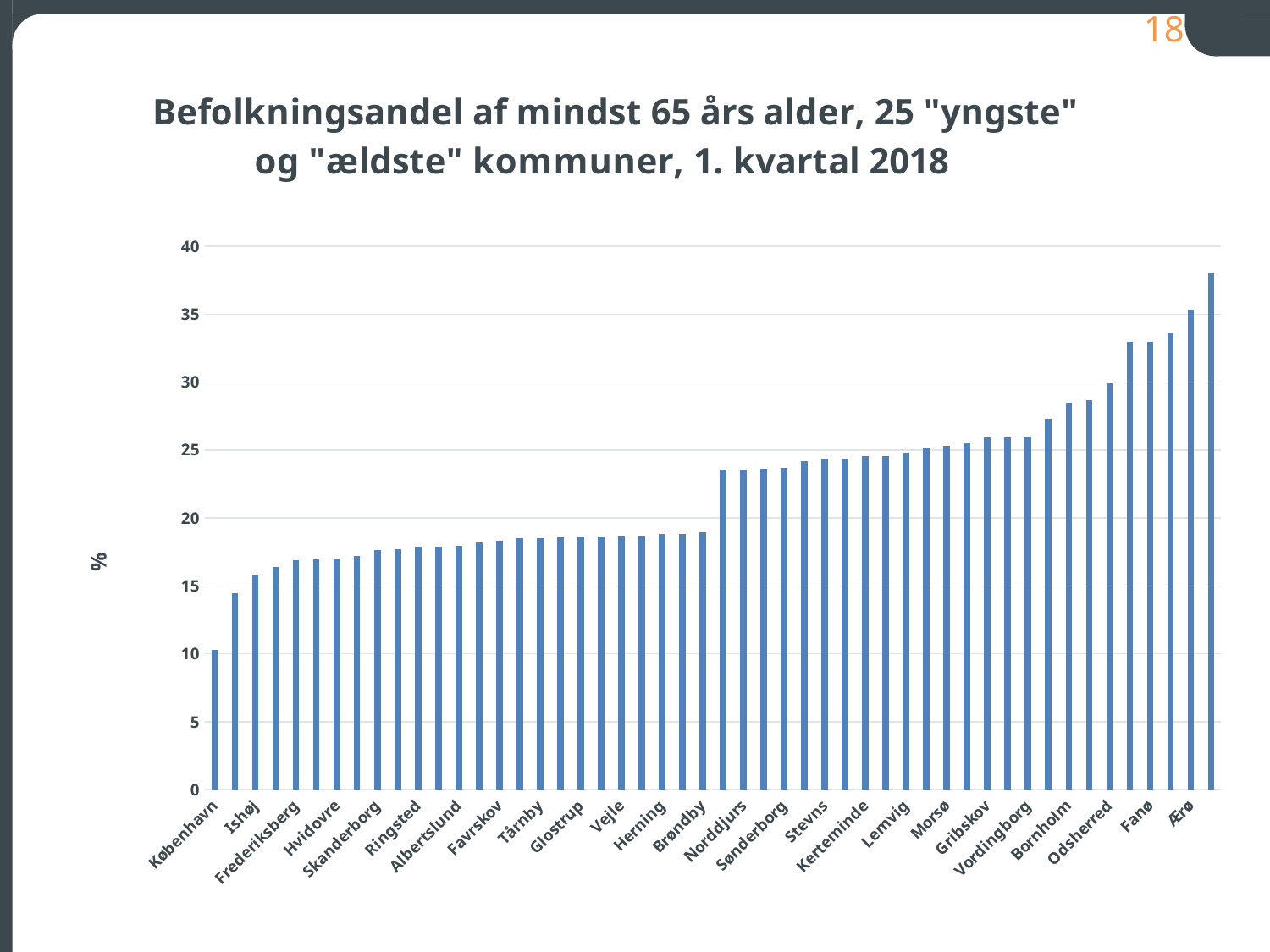
Is the value for Norddjurs greater or less than 20? greater What kind of chart is shown on the slide? bar chart Which has a larger value, Fanø or Bornholm? Fanø Is the value for Brøndby greater or less than 20? less Is the value for Bornholm greater or less than 25? greater What is the title of the chart? Befolkningsandel af mindst 65 års alder, 25 "yngste" og "ældste" kommuner, 1. kvartal 2018 Which municipality has the lowest value in the chart? København What is the label on the vertical axis of the chart? % Which has a larger value, Norddjurs or Brøndby? Norddjurs Do the values rise or fall from left to right along the x axis? rise